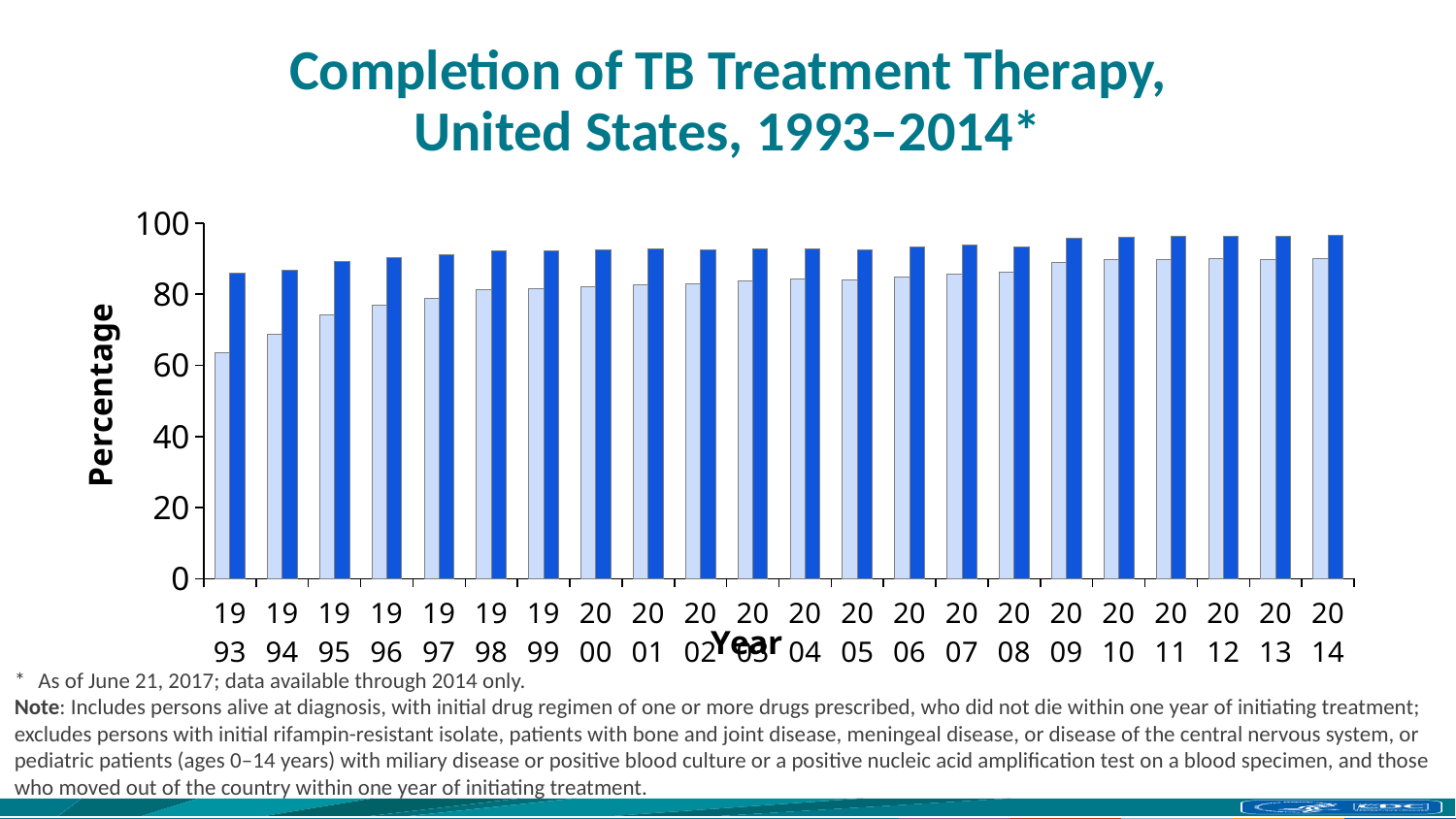
How many years are shown along the x axis of the chart? 22 Is the dark blue bar for 1993 greater or less than 80? greater Is the dark blue bar for 2014 greater or less than 80? greater Is the light blue bar for 1993 greater or less than 80? less What is the label of the vertical axis? Percentage In which year is the light blue bar the lowest? 1993 In 1993, which bar is taller, the light blue bar or the dark blue bar? dark blue bar How many bars are plotted for each year in the chart? 2 Do the light blue bars generally rise or fall from 1993 to 2014? rise What is the title of the chart? Completion of TB Treatment Therapy, United States, 1993–2014* What type of chart is shown on the slide? bar chart